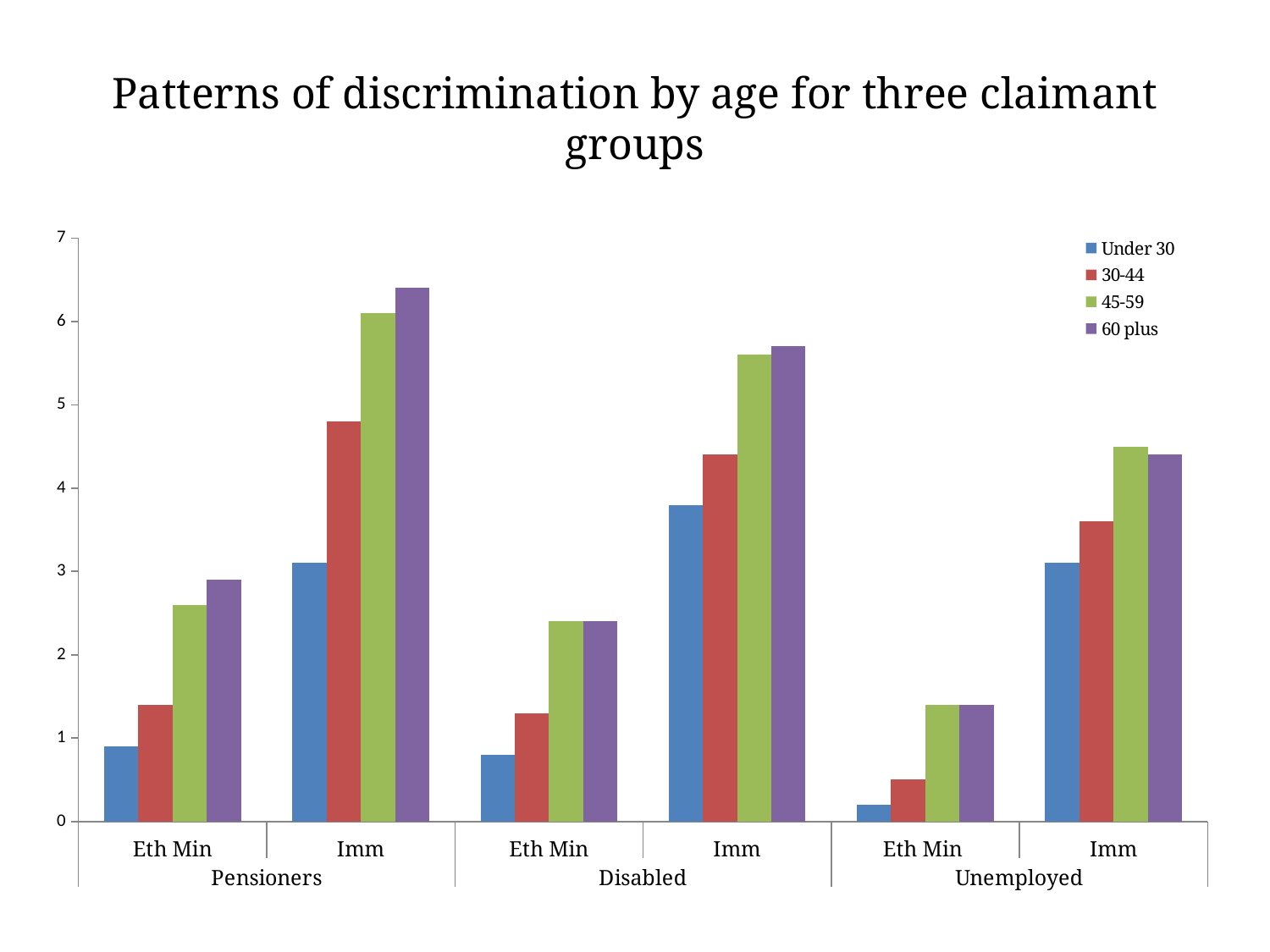
What kind of chart is shown on the slide? bar chart Which is larger: the 60 plus value for Imm under Pensioners or the 60 plus value for Imm under Disabled? Imm under Pensioners Is the value for 45-59 in the Unemployed Imm group greater or less than 4? greater Which bar is the shortest in the chart? Under 30 for Eth Min under Unemployed Which bar is the tallest in the chart? 60 plus for Imm under Pensioners Is the value for Under 30 in the Unemployed Eth Min group greater or less than 1? less How many series does the legend list? 4 How many claimant groups are shown along the x axis? 3 Is the value for 30-44 in the Pensioners Imm group greater or less than 4? greater For Eth Min under Pensioners, do the values rise or fall as the age group increases from Under 30 to 60 plus? rise What is the title of the chart? Patterns of discrimination by age for three claimant groups